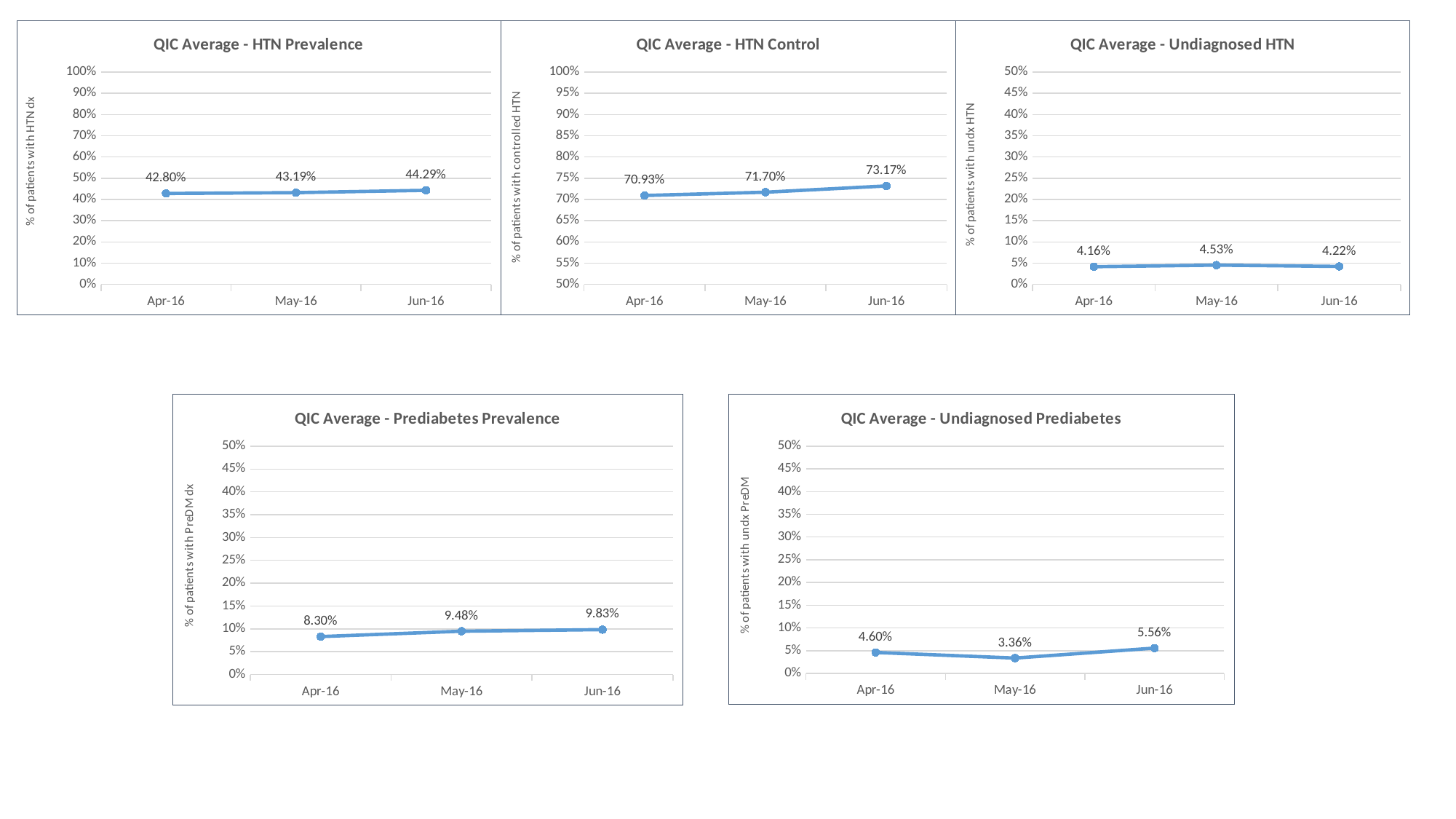
In the 'QIC Average - Undiagnosed Prediabetes' chart, which is larger, the value for Apr-16 or the value for Jun-16? Jun-16 In the 'QIC Average - HTN Prevalence' chart, what is the value for Jun-16? 44.29% How many charts are shown on the slide? 5 In the 'QIC Average - Undiagnosed Prediabetes' chart, which month has the lowest value? May-16 In the 'QIC Average - Undiagnosed HTN' chart, which month has the highest value? May-16 In the 'QIC Average - Prediabetes Prevalence' chart, what is the difference between the Jun-16 and Apr-16 values? 1.53% In the 'QIC Average - HTN Prevalence' chart, do the values rise or fall from Apr-16 to Jun-16? rise How many data points are plotted in the 'QIC Average - Prediabetes Prevalence' chart? 3 In the 'QIC Average - HTN Control' chart, what is the value for Apr-16? 70.93% In the 'QIC Average - HTN Prevalence' chart, is the value for May-16 greater or less than 50%? less What kind of chart is 'QIC Average - HTN Control'? line chart In the 'QIC Average - HTN Control' chart, what is the difference between the Jun-16 and May-16 values? 1.47%